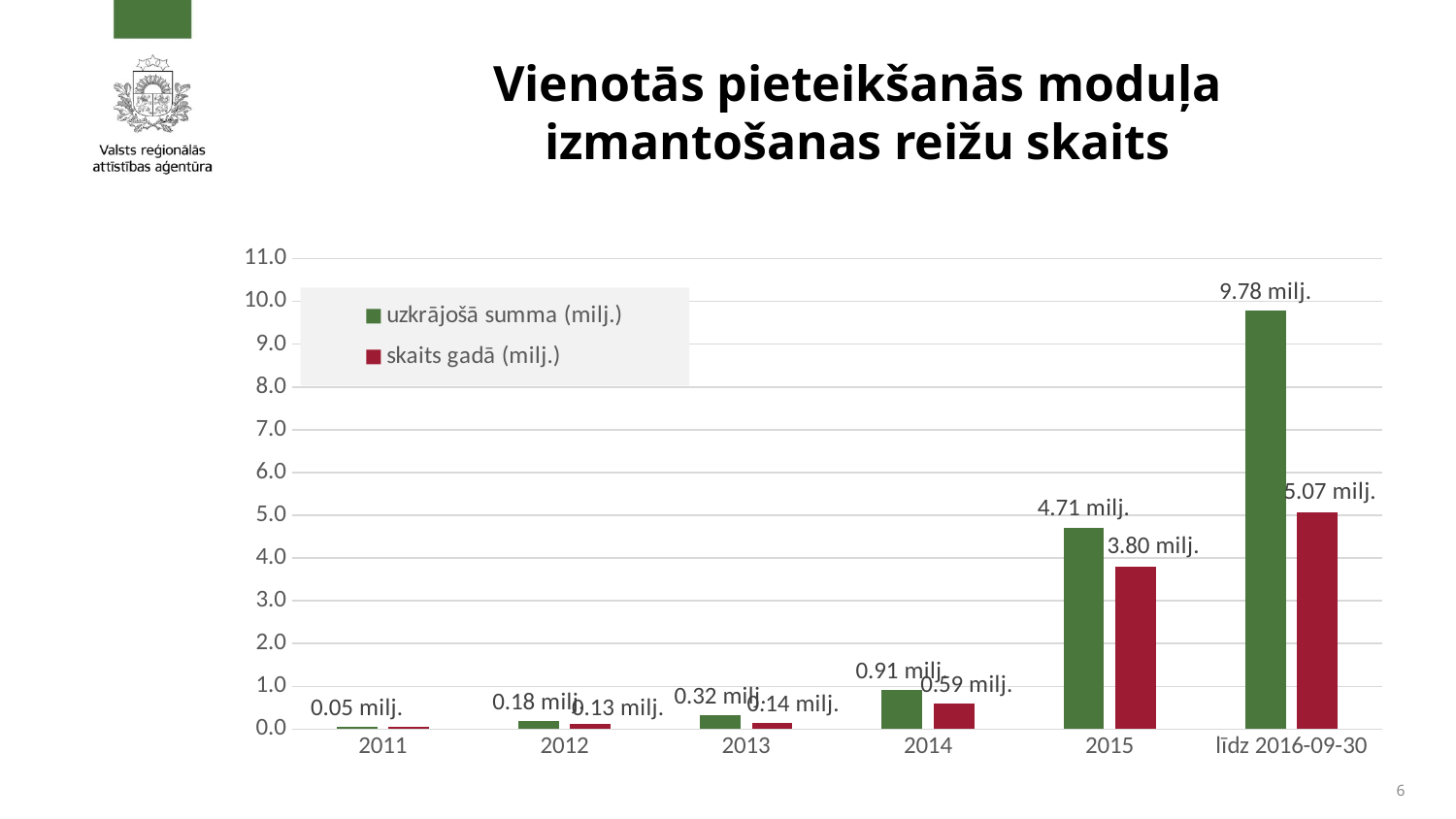
What is the value of uzkrājošā summa (milj.) for 2015? 4.71 milj. What is the difference between uzkrājošā summa and skaits gadā for 2015? 0.91 milj. How many categories are shown on the x axis? 6 Which category has the highest uzkrājošā summa (milj.)? līdz 2016-09-30 What is the value of skaits gadā (milj.) for 2014? 0.59 milj. Does uzkrājošā summa (milj.) rise or fall from 2011 to līdz 2016-09-30? rise How many series does the legend list? 2 What kind of chart is shown on the slide? bar chart What is the difference between uzkrājošā summa and skaits gadā for līdz 2016-09-30? 4.71 milj. What is the value of uzkrājošā summa (milj.) for līdz 2016-09-30? 9.78 milj. Which is larger: skaits gadā for 2015 or skaits gadā for līdz 2016-09-30? līdz 2016-09-30 What is the value of skaits gadā (milj.) for 2012? 0.13 milj.